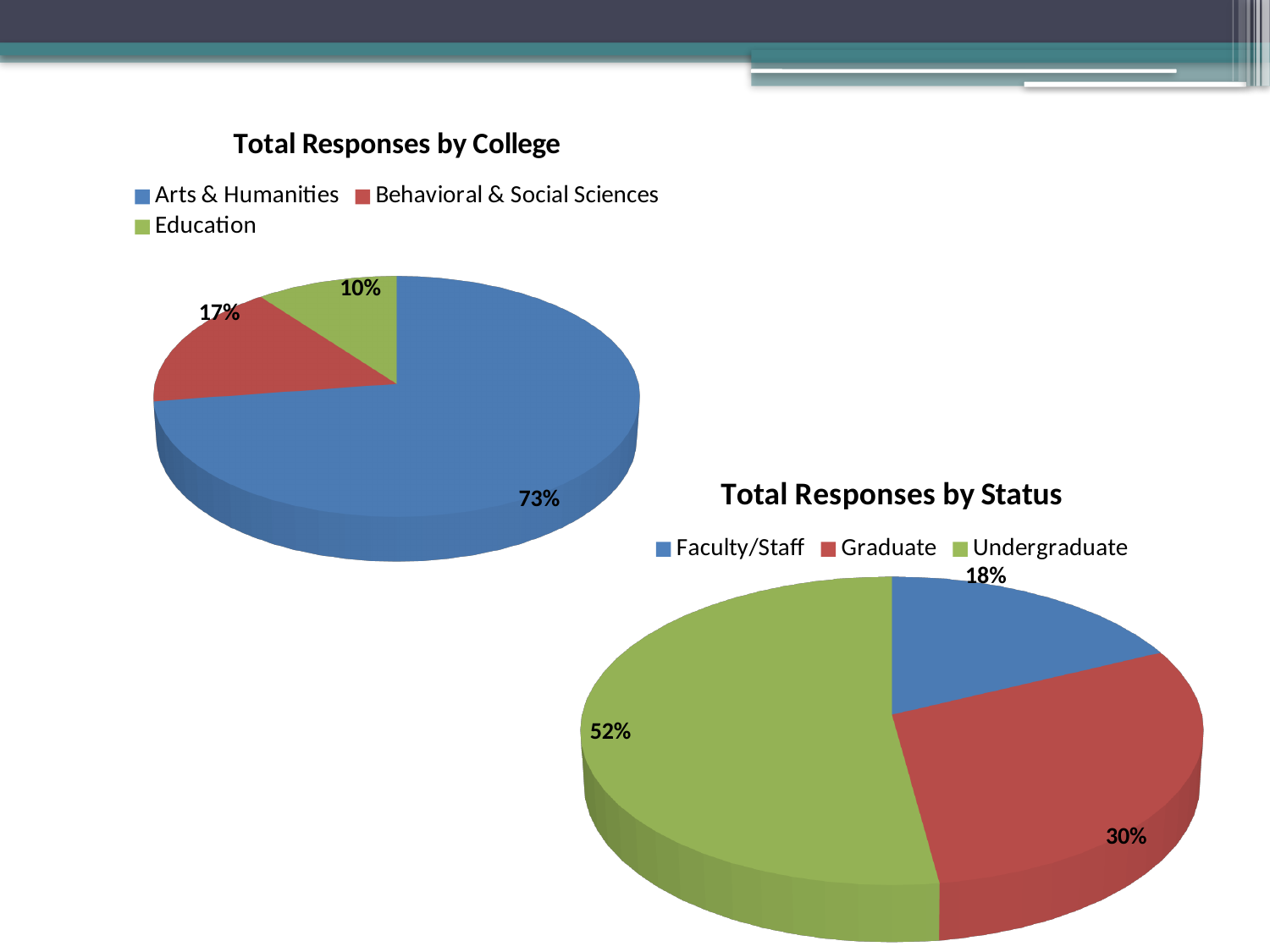
In the 'Total Responses by College' chart, what share of responses is from Education? 10% In the 'Total Responses by College' chart, what is the difference in percentage points between Arts & Humanities and Behavioral & Social Sciences? 56 What kind of chart is 'Total Responses by Status'? Pie chart In the 'Total Responses by College' chart, what share of responses is from Arts & Humanities? 73% In the 'Total Responses by College' chart, what share of responses is from Behavioral & Social Sciences? 17% In the 'Total Responses by Status' chart, which is larger, the Graduate share or the Faculty/Staff share? Graduate In the 'Total Responses by College' chart, which college has the smallest share of responses? Education In the 'Total Responses by Status' chart, which status group has the largest share of responses? Undergraduate In the 'Total Responses by College' chart, which college has the largest share of responses? Arts & Humanities